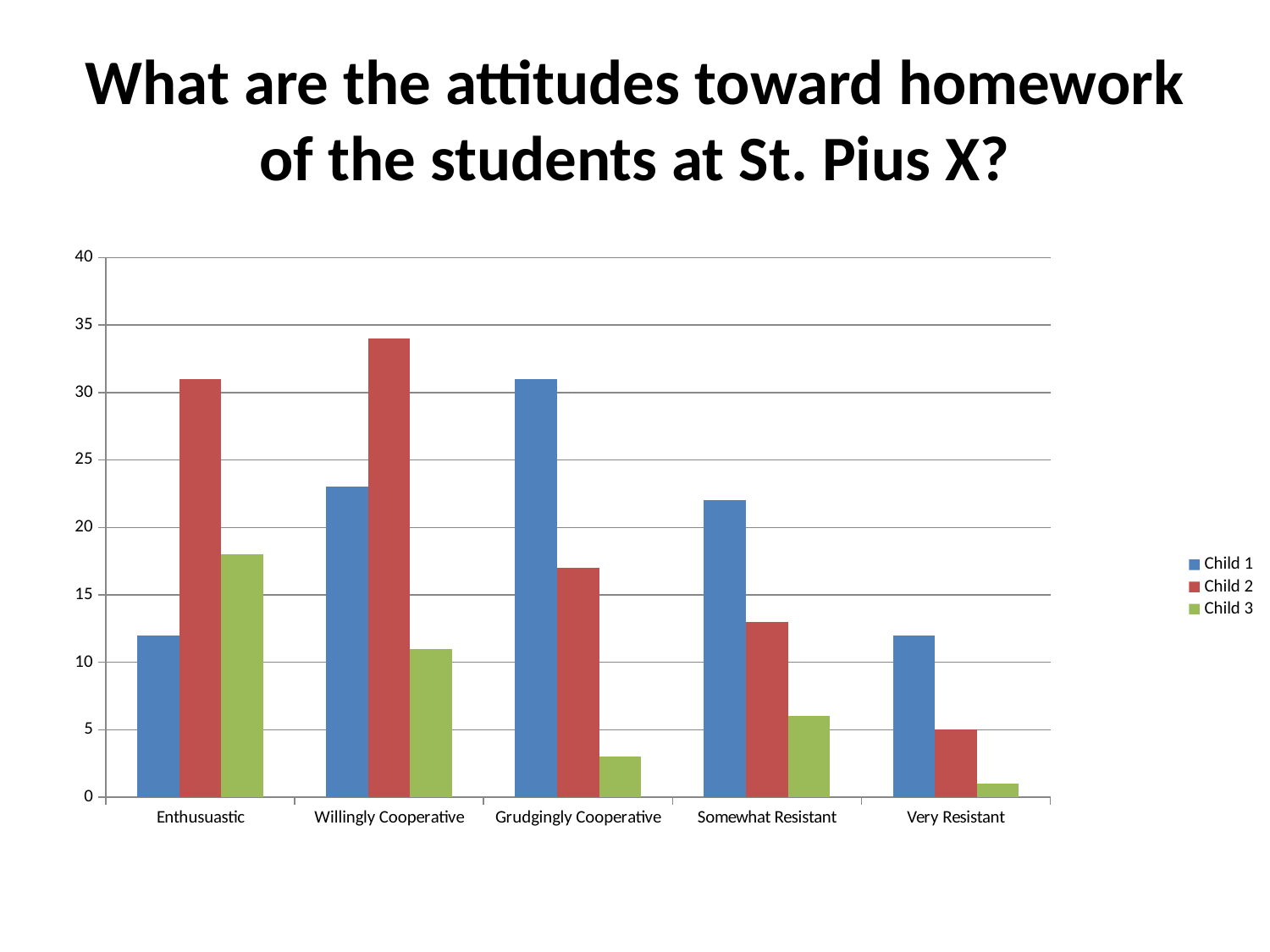
How many series does the chart's legend list? 3 For which category is the Child 1 bar the highest? Grudgingly Cooperative How many categories are shown on the x axis of the chart? 5 What are the series names listed in the legend? Child 1, Child 2, Child 3 What kind of chart is shown on the slide? bar chart Do the Child 2 values rise or fall from Willingly Cooperative to Very Resistant along the x axis? fall For which category is the Child 2 bar the highest? Willingly Cooperative In the Enthusuastic category, which is larger: the Child 1 bar or the Child 2 bar? Child 2 For which category is the Child 3 bar the lowest? Very Resistant Is the value for Child 3 in the Grudgingly Cooperative category greater or less than 5? less In the Very Resistant category, which is larger: the Child 1 bar or the Child 2 bar? Child 1 Is the value for Child 2 in the Willingly Cooperative category greater or less than 30? greater